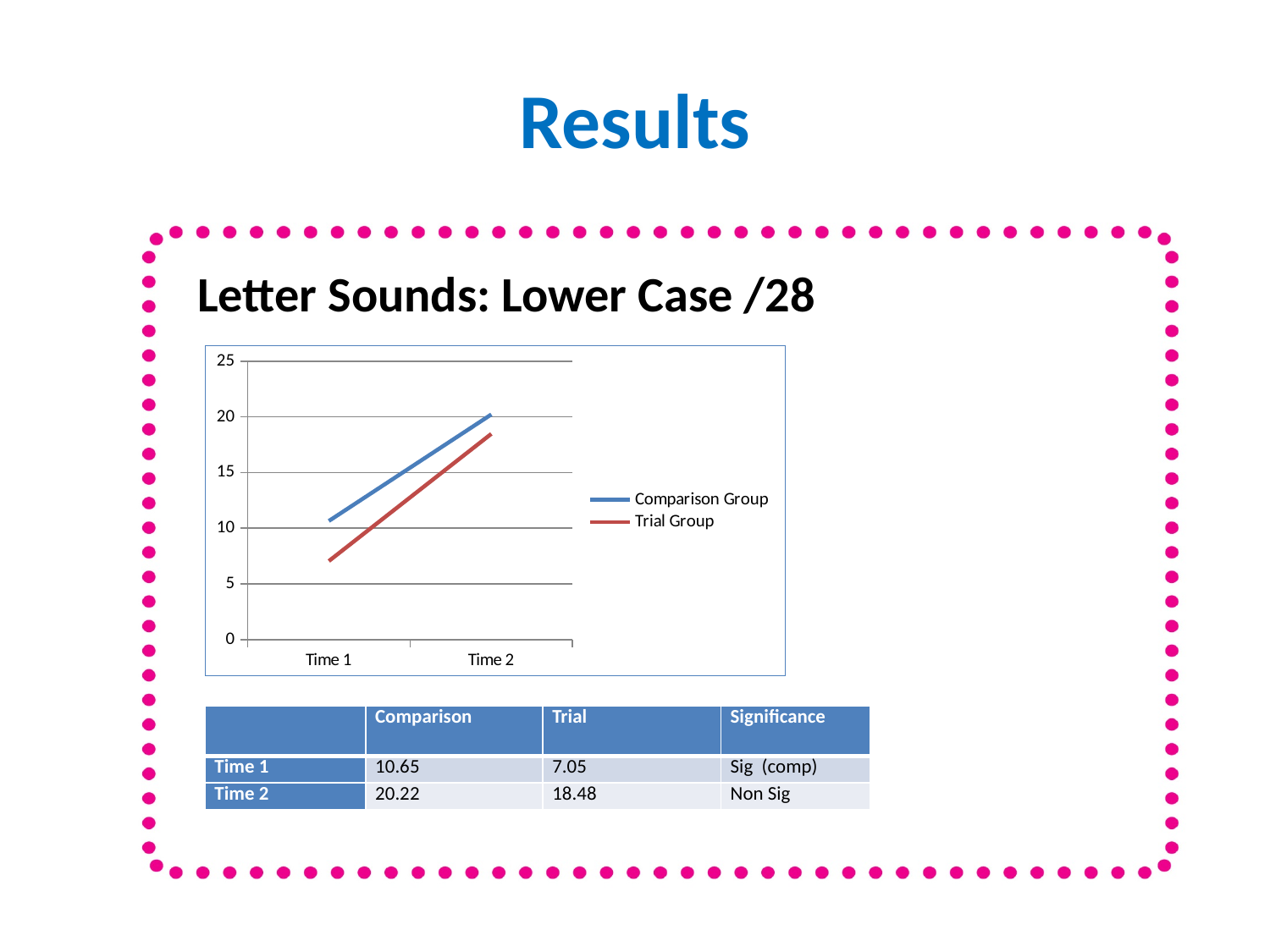
What kind of chart is shown on the slide? line chart What is the title above the chart? Letter Sounds: Lower Case /28 How many series does the chart legend list? 2 Using the table values, what is the difference between the Comparison and Trial values at Time 2? 1.74 How many points are on the x axis of the chart? 2 Which group has the higher value at Time 1? Comparison Group According to the table on the slide, what is the Comparison value at Time 1? 10.65 Do the values for the Trial Group rise or fall from Time 1 to Time 2? rise According to the table on the slide, what is the Trial value at Time 2? 18.48 Is the value for the Comparison Group at Time 2 greater or less than 20? greater Which series is shown in blue in the chart? Comparison Group Is the value for the Trial Group at Time 1 greater or less than 10? less